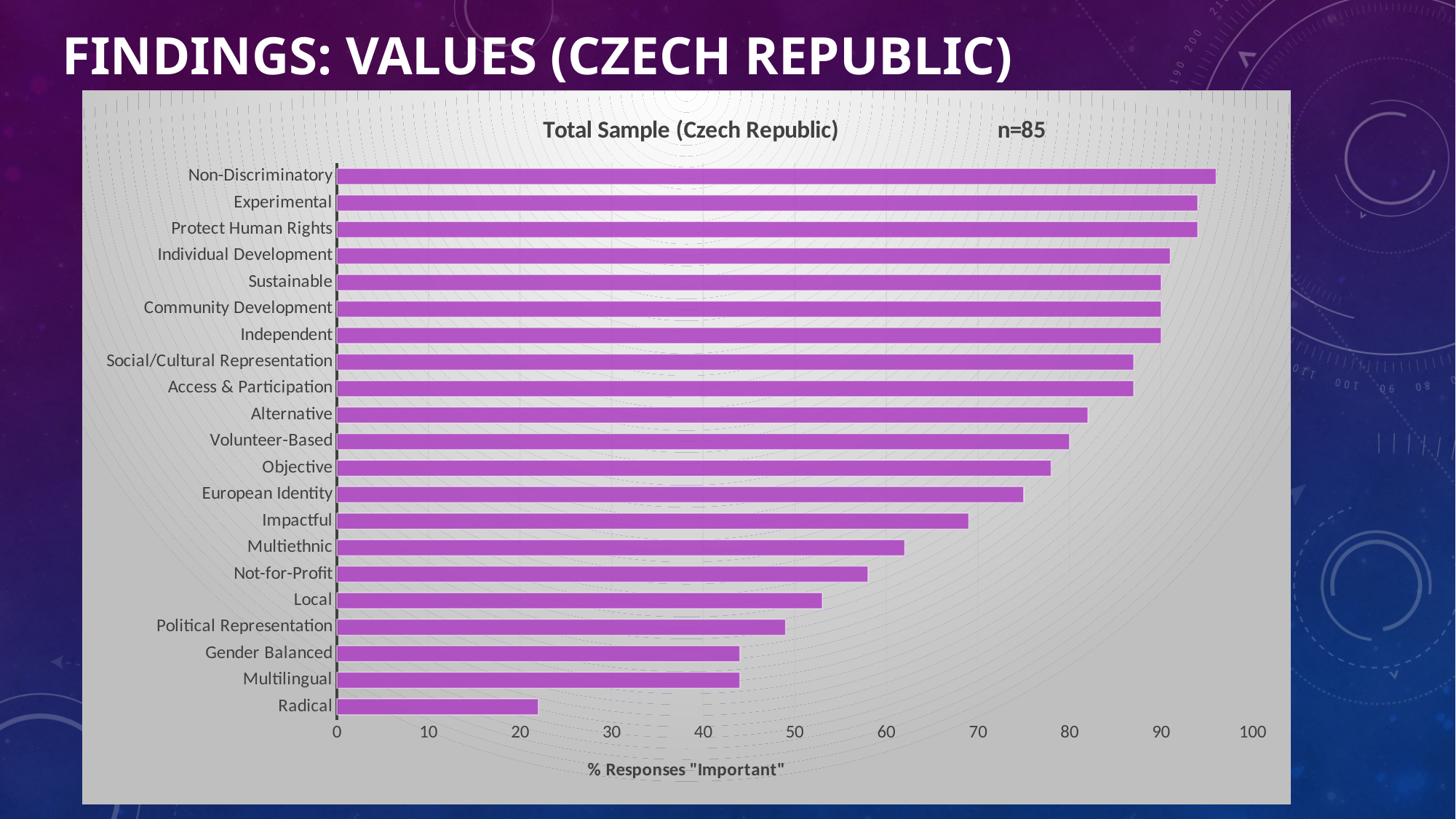
Which has a larger value, Impactful or Multiethnic? Impactful Which category has the highest value in the chart? Non-Discriminatory Is the value for Impactful greater or less than 60? greater What kind of chart is shown on the slide? bar chart How many categories are plotted in the chart? 21 Is the value for Radical greater or less than 30? less Is the value for Multilingual greater or less than 50? less Which has a larger value, Radical or Multilingual? Multilingual What is the sample size (n) shown on the chart? n=85 Which category has the lowest value in the chart? Radical